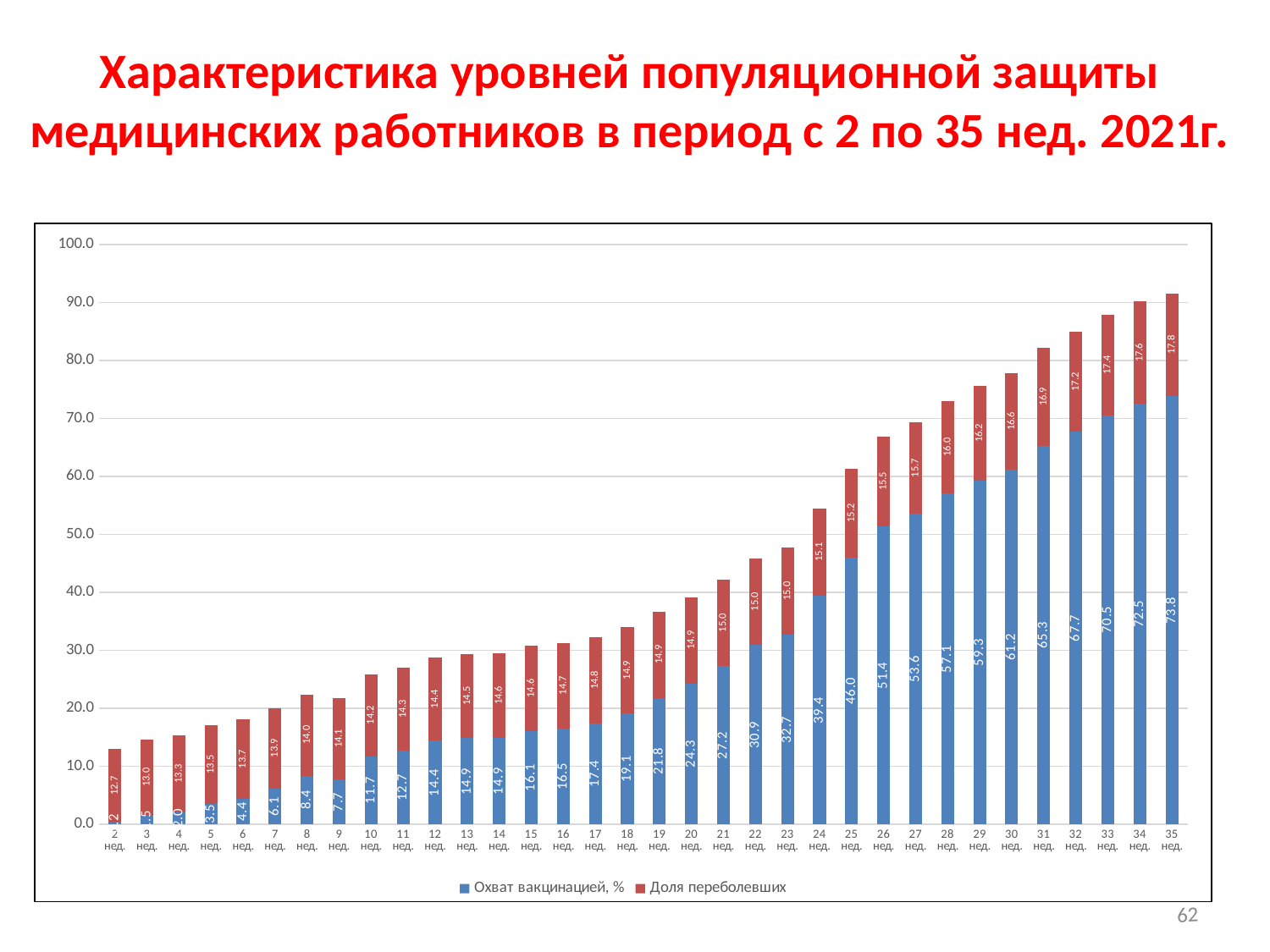
Does 'Охват вакцинацией, %' rise or fall from 10 нед. to 35 нед.? rise What is the value of 'Доля переболевших' for 10 нед.? 14.2 How many series does the legend list? 2 What is the total height of the stacked bar for 35 нед.? 91.6 Which week has the lowest value of 'Охват вакцинацией, %'? 2 нед. How many weeks (categories) are plotted along the x axis? 34 Which is larger: 'Охват вакцинацией, %' for 25 нед. or for 20 нед.? 25 нед. Which week has the highest value of 'Доля переболевших'? 35 нед. What is the value of 'Охват вакцинацией, %' for 35 нед.? 73.8 What is the difference in 'Охват вакцинацией, %' between 35 нед. and 34 нед.? 1.3 What is the value of 'Охват вакцинацией, %' for 24 нед.? 39.4 What type of chart is shown on the slide? stacked bar chart